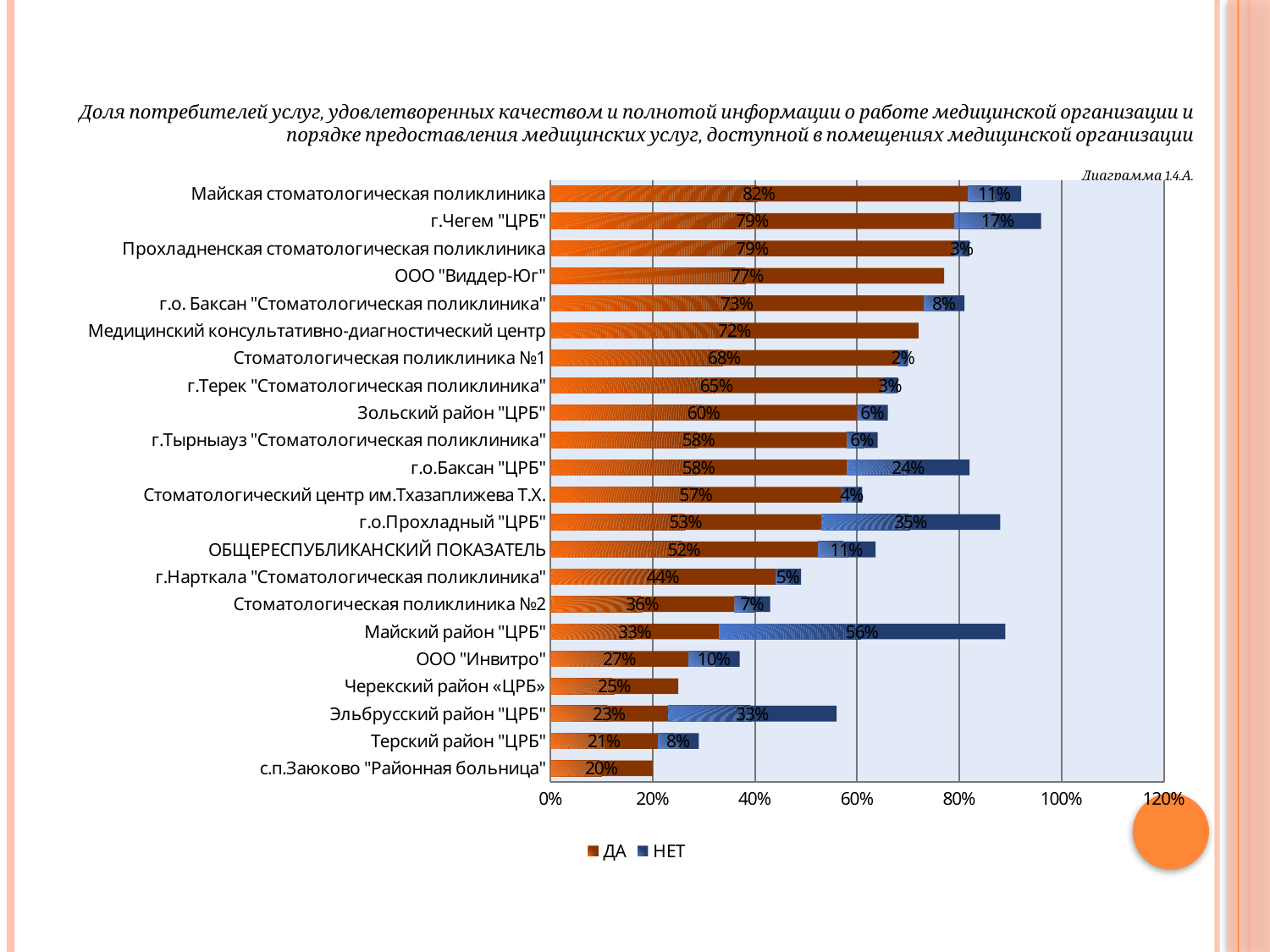
Which organisation has the lowest ДА value? с.п.Заюково "Районная больница" Which is larger: the НЕТ value for г.о.Прохладный "ЦРБ" or the НЕТ value for г.о.Баксан "ЦРБ"? г.о.Прохладный "ЦРБ" What is the difference between the ДА values of г.Чегем "ЦРБ" and Терский район "ЦРБ"? 58% What is the ДА value for Майская стоматологическая поликлиника? 82% How many organisations (categories) are shown on the chart? 22 What is the ДА value for ОБЩЕРЕСПУБЛИКАНСКИЙ ПОКАЗАТЕЛЬ? 52% Which series is shown in orange according to the legend? ДА What is the total of the stacked bar for Эльбрусский район "ЦРБ"? 56% What is the НЕТ value for Майский район "ЦРБ"? 56% Which organisation has the highest ДА value? Майская стоматологическая поликлиника How many series does the legend list? 2 What kind of chart is shown on the slide? Stacked horizontal bar chart